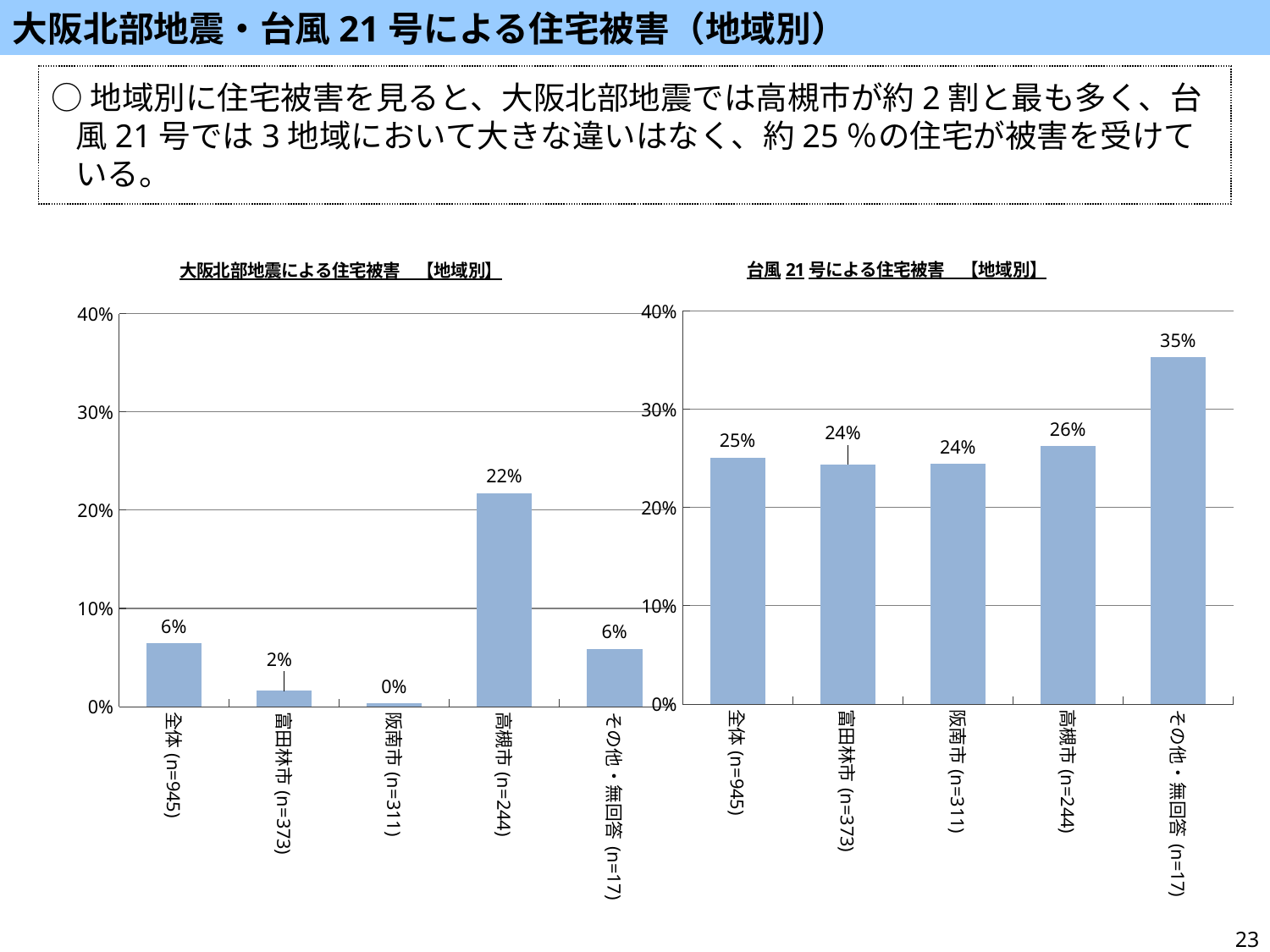
In the 大阪北部地震による住宅被害【地域別】 chart on the left, what is the value for 全体 (n=945)? 6% In the 台風21号による住宅被害【地域別】 chart on the right, what is the value for その他・無回答 (n=17)? 35% What type of chart is the 大阪北部地震による住宅被害【地域別】 chart on the left? Bar chart In the 台風21号による住宅被害【地域別】 chart on the right, what is the difference between the values for その他・無回答 (n=17) and 高槻市 (n=244)? 9% In the 大阪北部地震による住宅被害【地域別】 chart on the left, what is the value for 高槻市 (n=244)? 22% In the 大阪北部地震による住宅被害【地域別】 chart on the left, which is larger, the value for 高槻市 (n=244) or the value for 富田林市 (n=373)? 高槻市 (n=244) In the 大阪北部地震による住宅被害【地域別】 chart on the left, what is the difference between the values for 高槻市 (n=244) and 全体 (n=945)? 16% In the 大阪北部地震による住宅被害【地域別】 chart on the left, which category has the lowest value? 阪南市 (n=311) In the 大阪北部地震による住宅被害【地域別】 chart on the left, which category has the highest value? 高槻市 (n=244) In the 台風21号による住宅被害【地域別】 chart on the right, which category has the highest value? その他・無回答 (n=17) How many categories are shown in the 台風21号による住宅被害【地域別】 chart on the right? 5 In the 台風21号による住宅被害【地域別】 chart on the right, what is the value for 高槻市 (n=244)? 26%